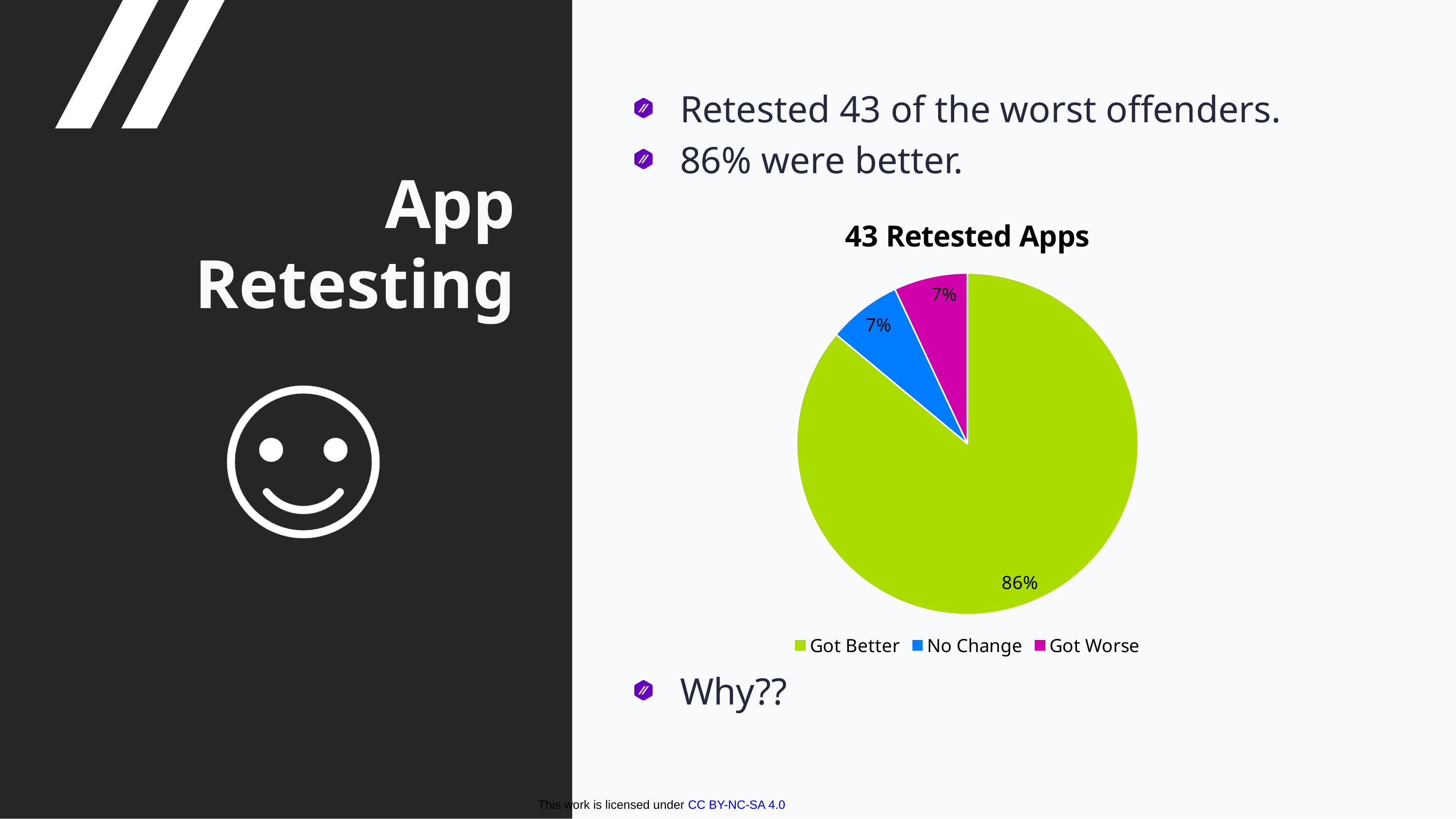
What colour represents the Got Worse category in the pie chart? Magenta How many entries are listed in the chart legend? 3 How many categories does the pie chart show? 3 What is the difference in percentage points between the Got Better slice and the Got Worse slice? 79 percentage points Which category has the largest slice of the pie? Got Better What type of chart is shown on the slide? Pie chart What is the title of the chart? 43 Retested Apps What percentage of the retested apps Got Worse? 7% Which is larger, the share for Got Better or the share for No Change? Got Better What percentage of the retested apps Got Better? 86% What percentage of the retested apps had No Change? 7% What share of the pie does the Got Better slice represent? 86%